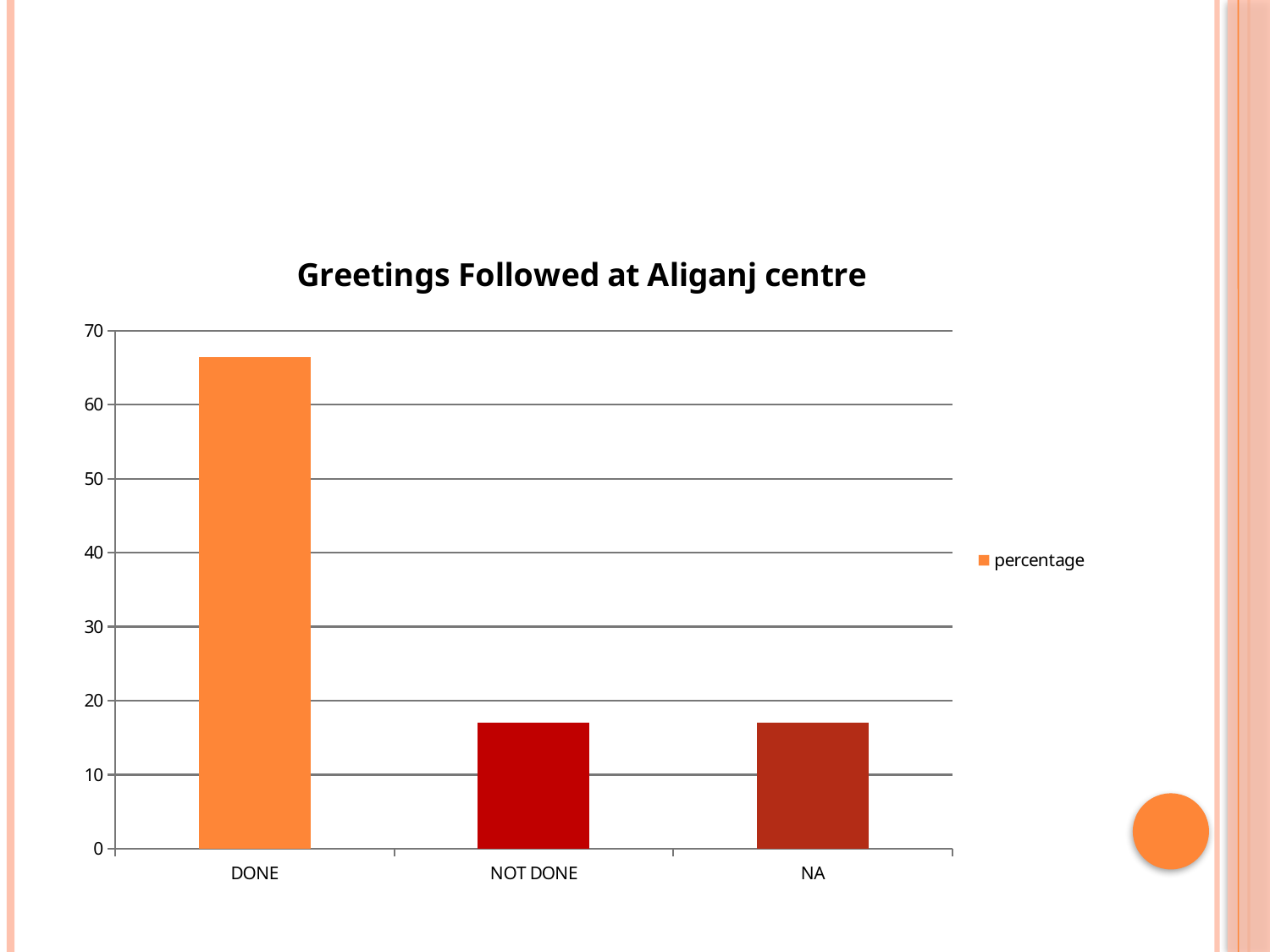
Is the value for DONE greater or less than 70? less What kind of chart is shown on the slide? bar chart How many series does the legend list? 1 What series name is shown in the legend? percentage Which is larger, the value for DONE or the value for NA? DONE Is the value for NA greater or less than 20? less What is the title of the chart? Greetings Followed at Aliganj centre Which category has the highest value? DONE Is the value for DONE greater or less than 60? greater How many categories are shown on the x axis of the chart? 3